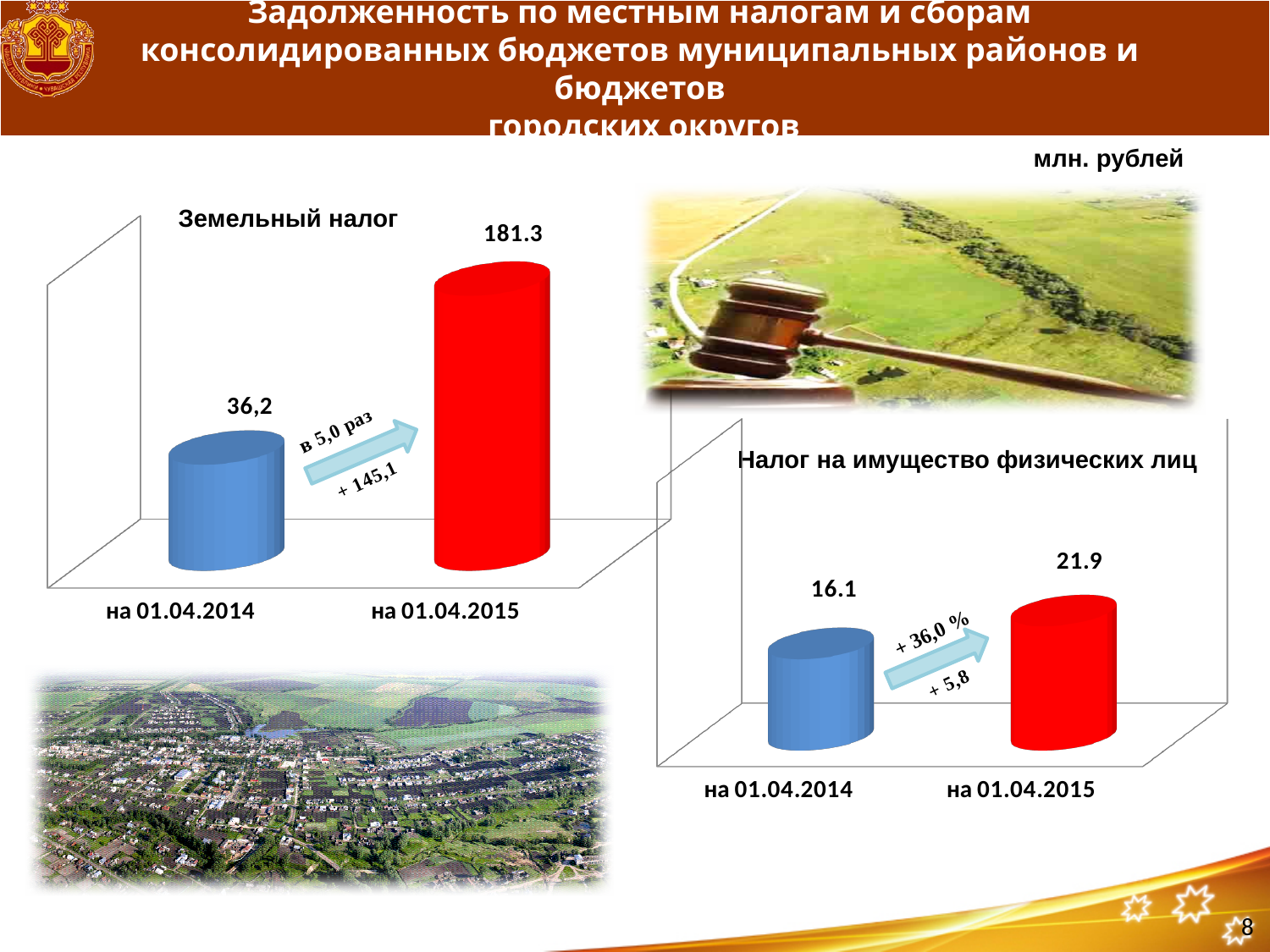
In the 'Земельный налог' chart, which date has the higher value? на 01.04.2015 In the 'Налог на имущество физических лиц' chart, what is the difference between the values for на 01.04.2015 and на 01.04.2014? 5,8 In the 'Налог на имущество физических лиц' chart, what is the value for на 01.04.2015? 21.9 What unit of measurement is stated for the charts on the slide? млн. рублей In the 'Земельный налог' chart, what is the value for на 01.04.2014? 36,2 Is the value for на 01.04.2015 in the 'Земельный налог' chart larger than the value for на 01.04.2015 in the 'Налог на имущество физических лиц' chart? Yes In the 'Земельный налог' chart, what is the difference between the values for на 01.04.2015 and на 01.04.2014? 145,1 In the 'Земельный налог' chart, what is the value for на 01.04.2015? 181.3 What kind of chart is the 'Налог на имущество физических лиц' chart? Bar chart How many categories are shown in the 'Земельный налог' chart? 2 In the 'Налог на имущество физических лиц' chart, what is the value for на 01.04.2014? 16.1 In the 'Налог на имущество физических лиц' chart, which date has the lower value? на 01.04.2014